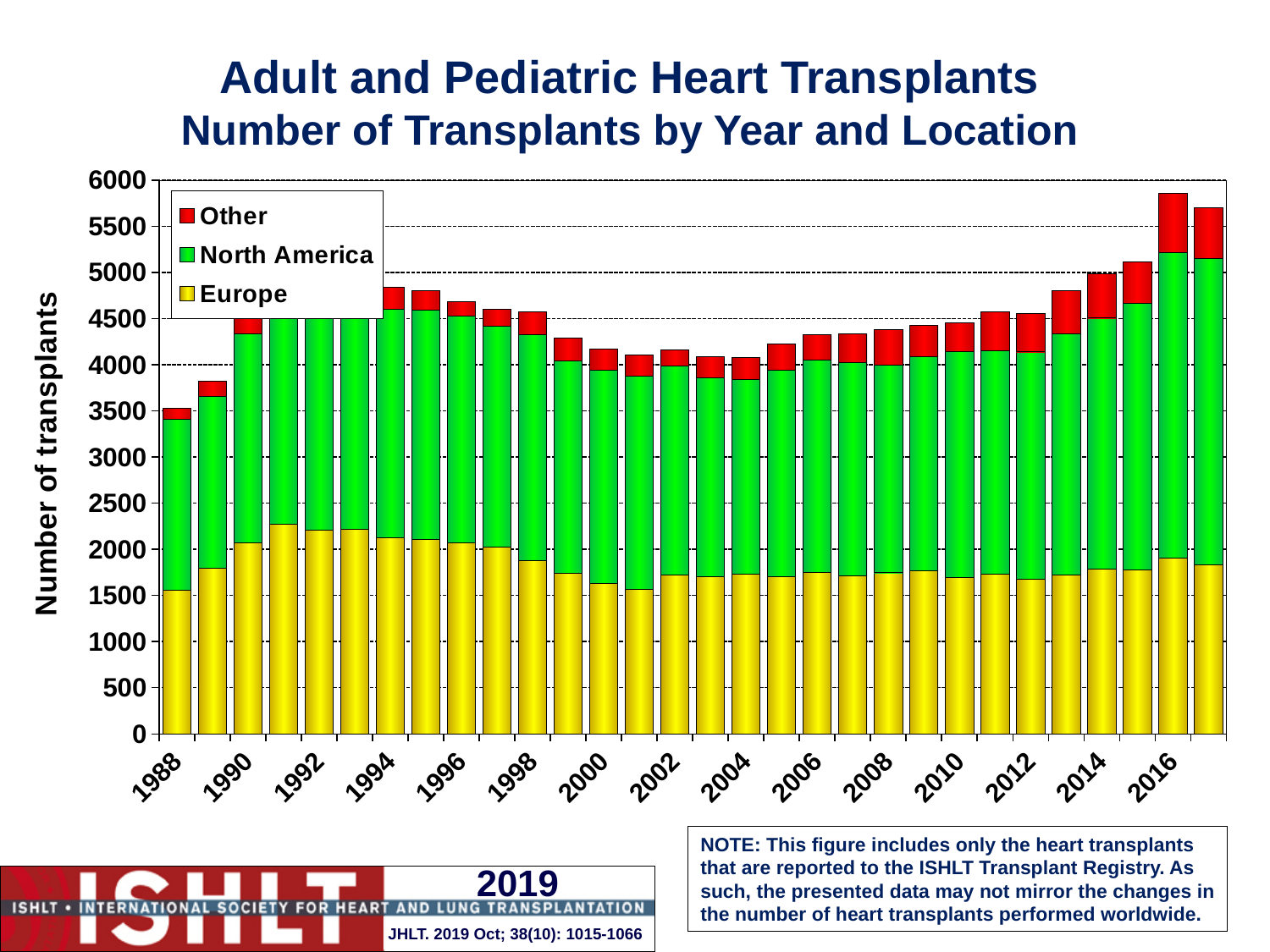
Which year has the larger total number of transplants, 2016 or 2017? 2016 Which year has the lowest total number of transplants? 1988 Is the total number of transplants for 1988 greater or less than 4000? less How many series does the legend list? 3 Do the total numbers of transplants rise or fall from 2004 to 2016? rise What is the title of the vertical axis? Number of transplants What kind of chart is shown on the slide? Stacked bar chart Is the Europe value for 1988 greater or less than 2000? less Which year has the highest total number of transplants? 2016 Which year has the larger Europe value, 1988 or 1991? 1991 Is the total number of transplants for 2004 greater or less than 4500? less